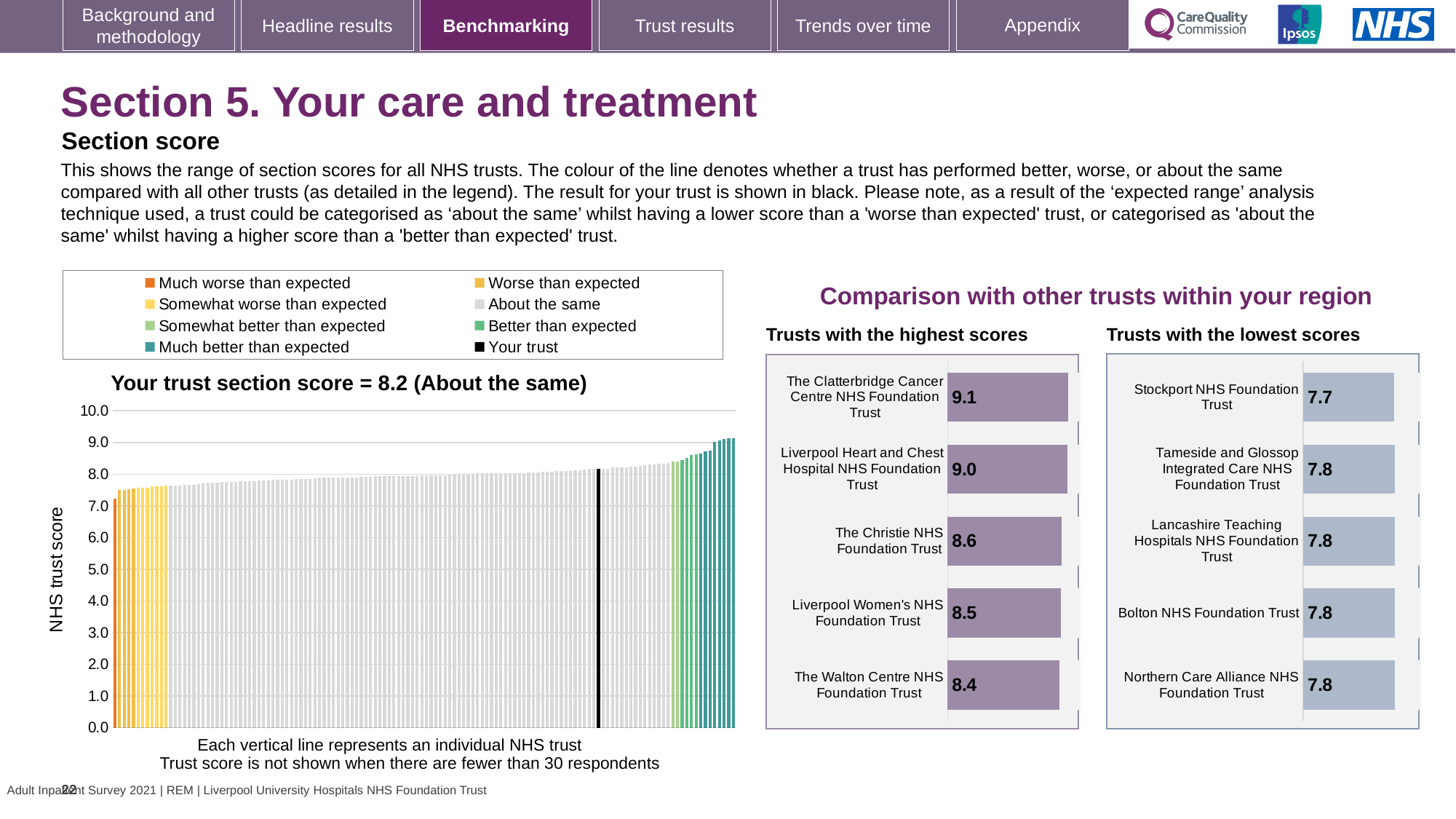
How many trusts are shown in the 'Trusts with the lowest scores' chart? 5 In the 'Trusts with the lowest scores' chart, which trust has the lowest score? Stockport NHS Foundation Trust How many entries does the legend above the main 'Your trust section score' chart list? 8 In the 'Trusts with the highest scores' chart, what is the score for The Walton Centre NHS Foundation Trust? 8.4 In the 'Trusts with the highest scores' chart, which trust has the highest score? The Clatterbridge Cancer Centre NHS Foundation Trust In the main chart titled 'Your trust section score', do the trust scores rise or fall from left to right? rise In the main chart titled 'Your trust section score', what is the section score for your trust? 8.2 In the 'Trusts with the highest scores' chart, what is the score for The Clatterbridge Cancer Centre NHS Foundation Trust? 9.1 In the 'Trusts with the lowest scores' chart, what is the score for Stockport NHS Foundation Trust? 7.7 What kind of chart is the 'Trusts with the highest scores' chart? bar chart In the 'Trusts with the highest scores' chart, what is the difference between the scores of The Clatterbridge Cancer Centre NHS Foundation Trust and The Walton Centre NHS Foundation Trust? 0.7 In the 'Trusts with the highest scores' chart, which has the larger score: The Christie NHS Foundation Trust or Liverpool Women's NHS Foundation Trust? The Christie NHS Foundation Trust